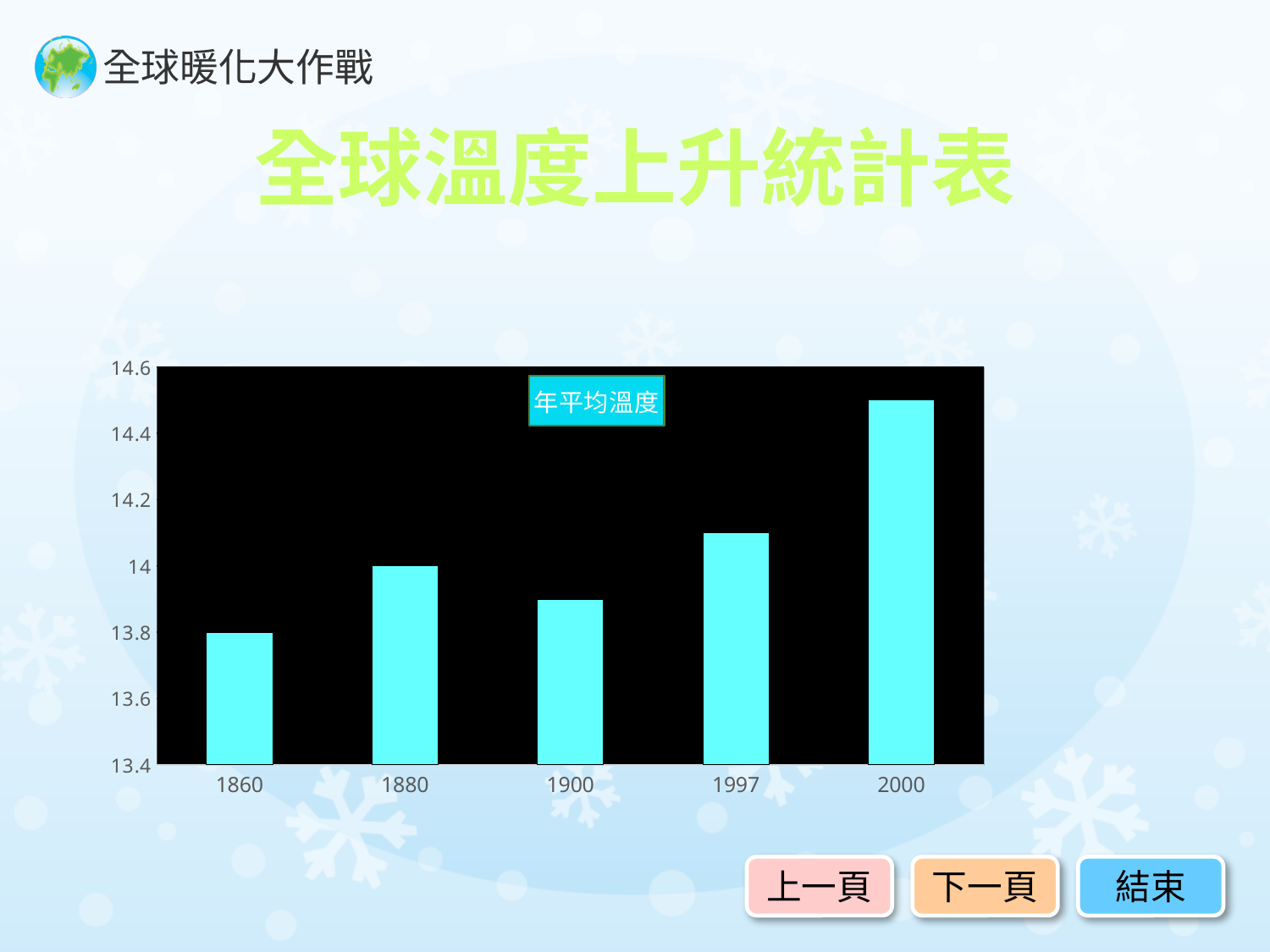
What is the value for 1880? 14 Is the value for 2000 greater or less than 14.4? greater Which year has the lowest value? 1860 How many years are shown on the x axis of the chart? 5 What type of chart is shown on the slide? bar chart What is the name of the series shown in the chart's legend? 年平均溫度 What is the difference between the values for 1880 and 1860? 0.2 What is the title of the chart on the slide? 年平均溫度 What is the value for 1860? 13.8 Is the value for 1900 greater or less than 14? less How many series does the chart's legend list? 1 Which year has the highest value? 2000